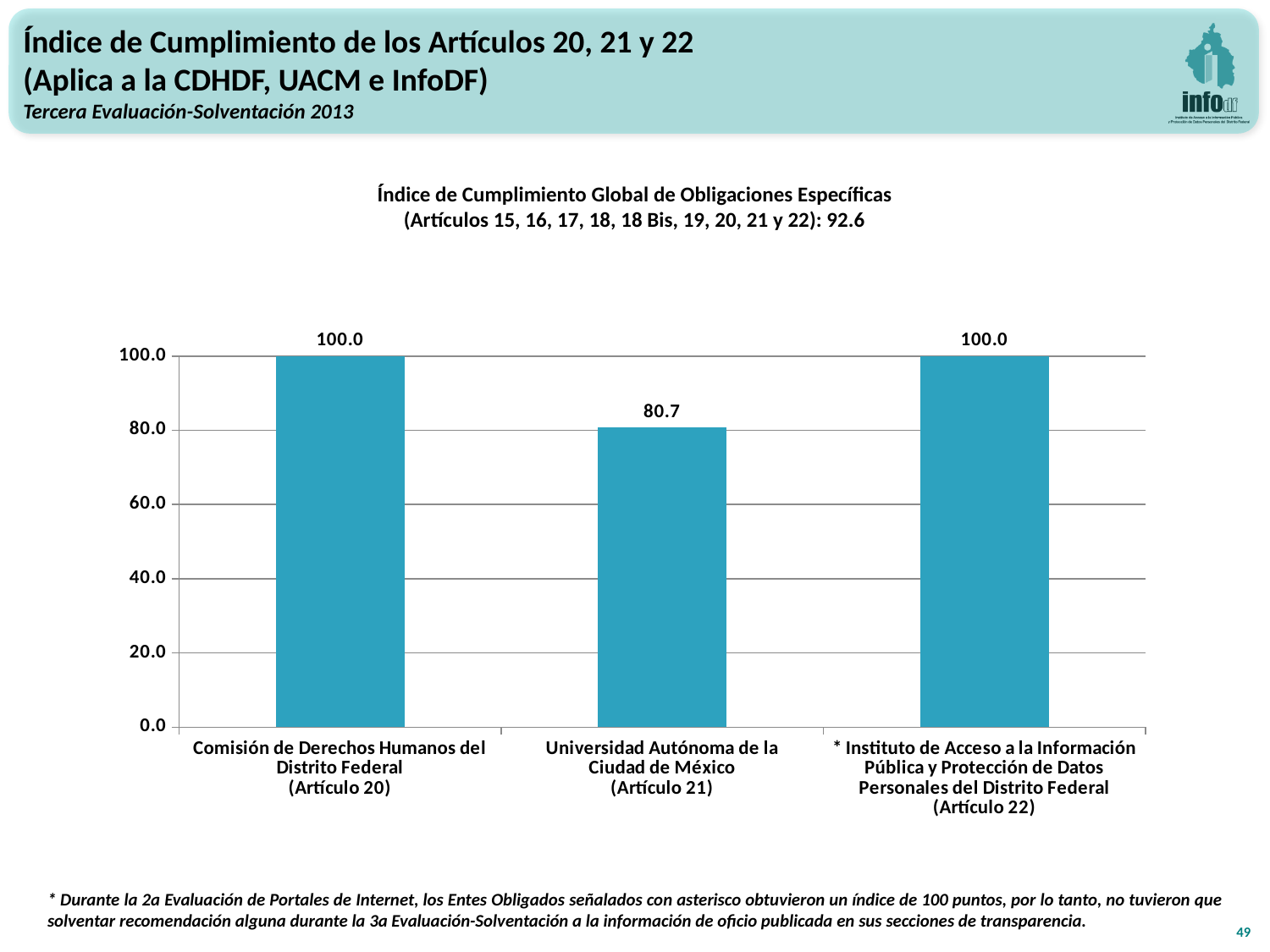
What is the difference between the value for Comisión de Derechos Humanos del Distrito Federal (Artículo 20) and the value for Universidad Autónoma de la Ciudad de México (Artículo 21)? 19.3 Which is larger: the value for Universidad Autónoma de la Ciudad de México (Artículo 21) or the value for Instituto de Acceso a la Información Pública y Protección de Datos Personales del Distrito Federal (Artículo 22)? Instituto de Acceso a la Información Pública y Protección de Datos Personales del Distrito Federal (Artículo 22) What is the value for Instituto de Acceso a la Información Pública y Protección de Datos Personales del Distrito Federal (Artículo 22)? 100.0 Which category has the lowest value? Universidad Autónoma de la Ciudad de México (Artículo 21) How many categories are shown in the chart? 3 What is the Índice de Cumplimiento Global de Obligaciones Específicas stated above the chart? 92.6 What is the value for Universidad Autónoma de la Ciudad de México (Artículo 21)? 80.7 What is the highest value shown on the vertical axis? 100.0 Is the value for Universidad Autónoma de la Ciudad de México (Artículo 21) greater or less than 60.0? greater What is the value for Comisión de Derechos Humanos del Distrito Federal (Artículo 20)? 100.0 What kind of chart is shown on the slide? bar chart